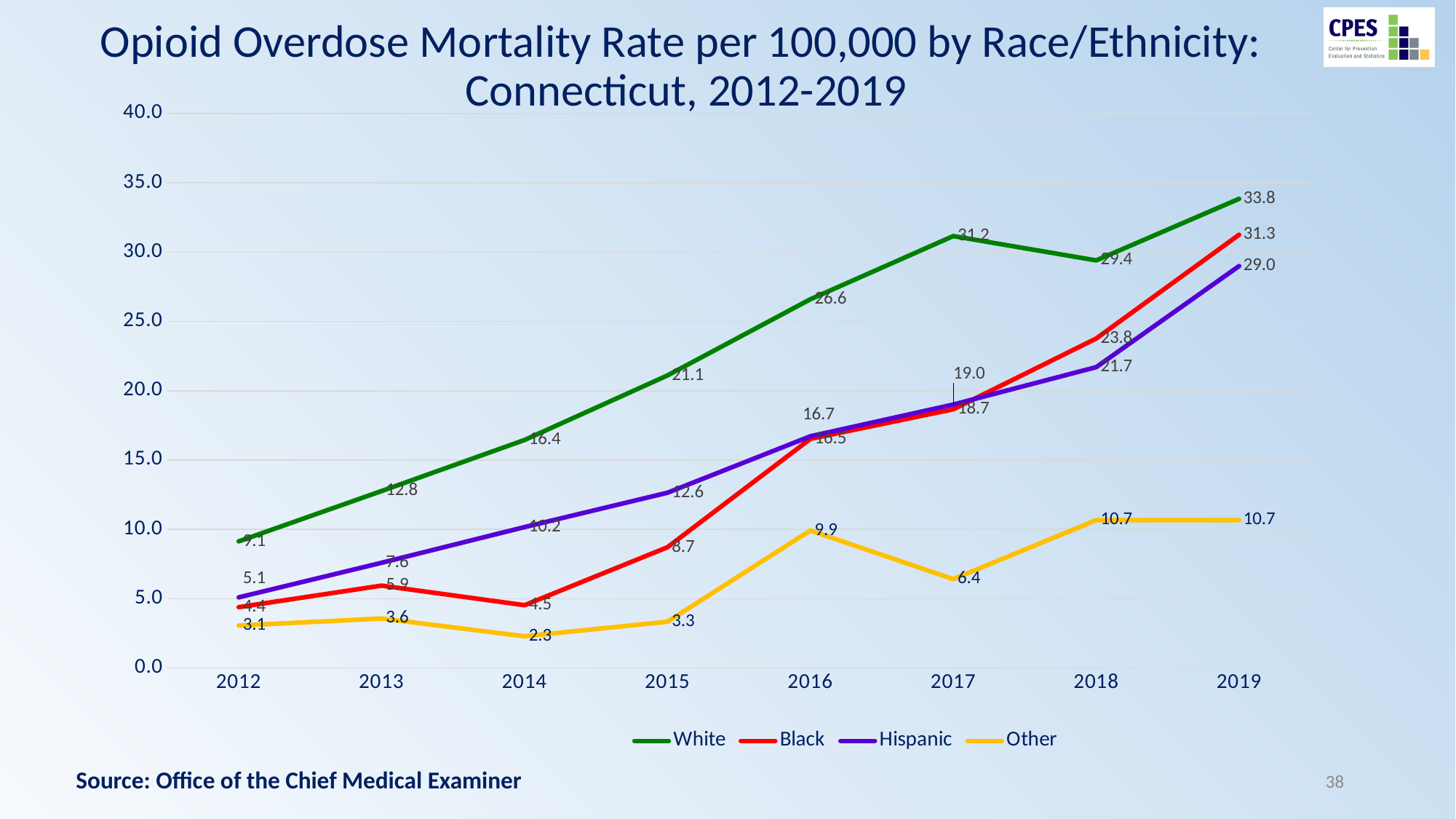
How many series does the legend list? 4 What is the difference between the White rate in 2019 and the White rate in 2018? 4.4 How many years are plotted along the x axis? 8 Which series has the highest value in 2019? White In which year was the White mortality rate lowest? 2012 Which is larger in 2017, the White rate or the Black rate? White What type of chart is shown on the slide? line chart What is the opioid overdose mortality rate for Other in 2014? 2.3 What is the opioid overdose mortality rate for White in 2019? 33.8 What is the opioid overdose mortality rate for Hispanic in 2015? 12.6 What is the opioid overdose mortality rate for Black in 2018? 23.8 Which series is drawn in green? White